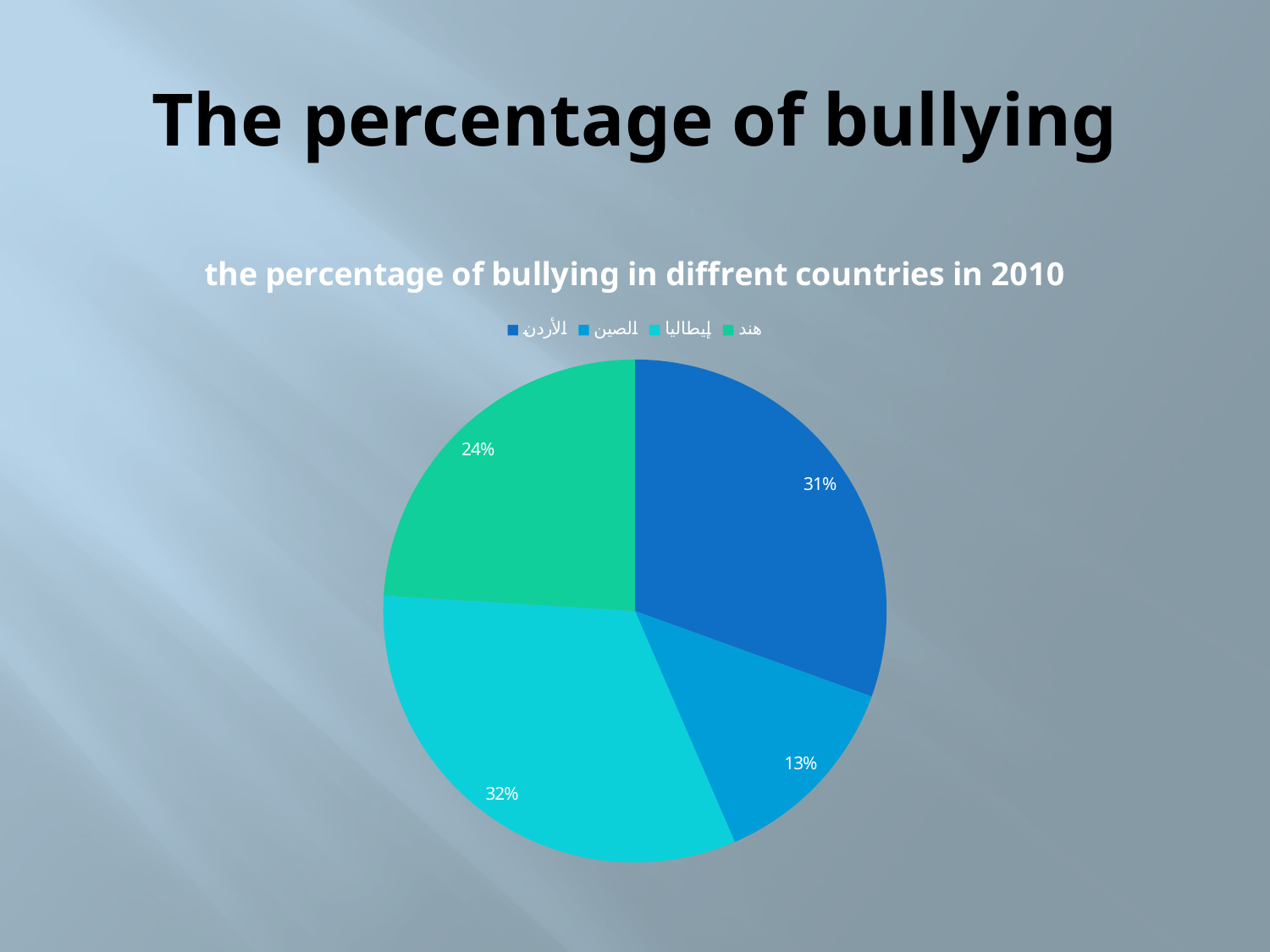
Which is larger, the share for هند or the share for الصين? هند How many entries does the legend list? 4 What is the title of the chart? the percentage of bullying in diffrent countries in 2010 Which slice has the smallest share of the pie? الصين (13%) What is the difference between the share for الأردن and the share for الصين? 18% What kind of chart is shown on the slide? pie chart What percentage is shown for the cyan slice (إيطاليا)? 32% Which slice has the largest share of the pie? إيطاليا (32%) What percentage is shown for the green slice (هند)? 24% What percentage is shown for the dark blue slice (الأردن)? 31% What percentage is shown for the medium blue slice (الصين)? 13% How many slices does the pie chart have? 4